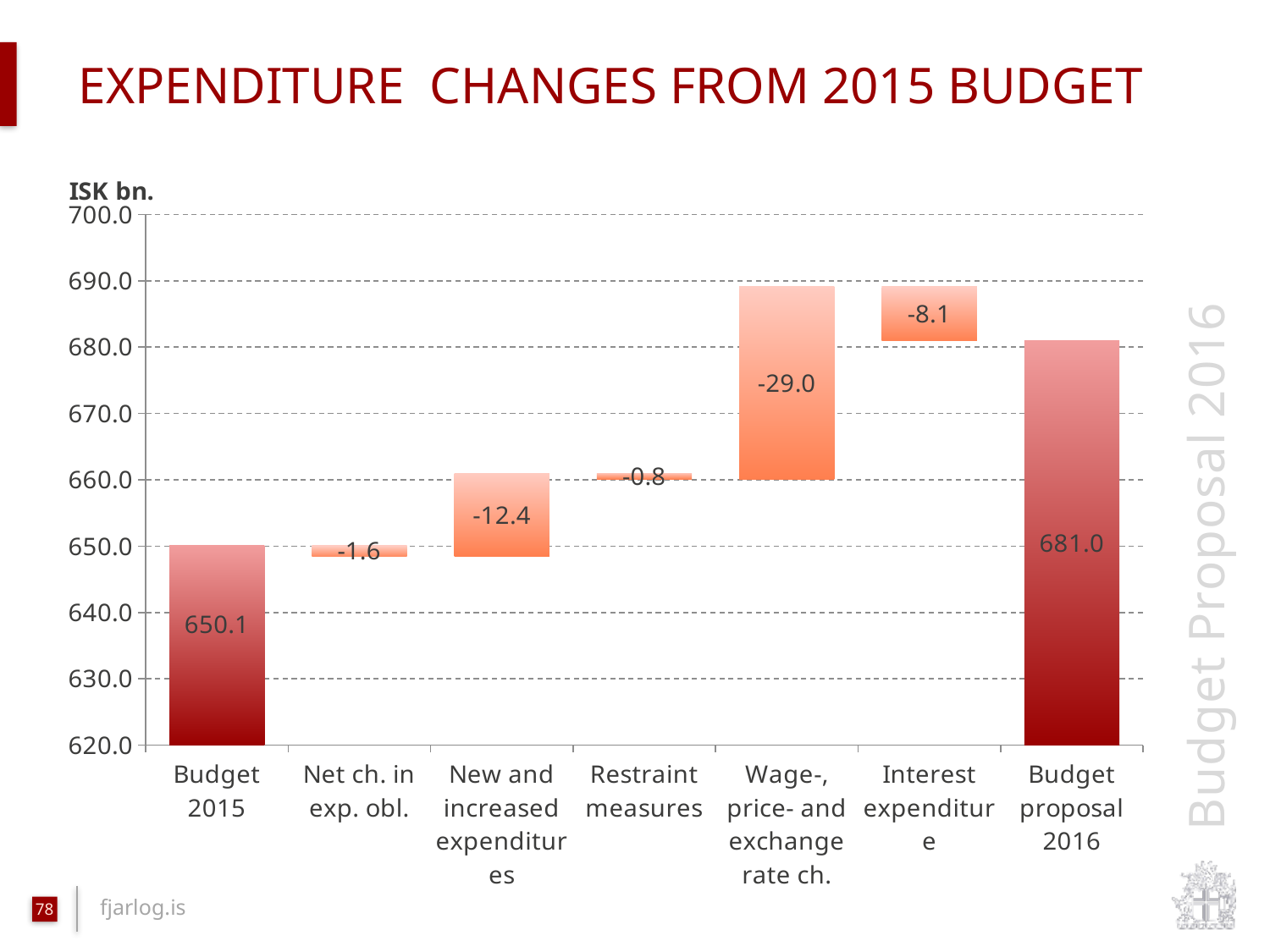
What value is labelled on the Net ch. in exp. obl. bar? -1.6 Which is larger, the value for Budget 2015 or the value for Budget proposal 2016? Budget proposal 2016 What is the value shown for Budget 2015? 650.1 What unit is indicated above the vertical axis? ISK bn. How many categories are shown on the x axis? 7 What kind of chart is shown on the slide? Bar chart By how much does the Budget proposal 2016 value exceed the Budget 2015 value? 30.9 What value is labelled on the New and increased expenditures bar? -12.4 What value is labelled on the Restraint measures bar? -0.8 What value is labelled on the Wage-, price- and exchange rate ch. bar? -29.0 What value is labelled on the Interest expenditure bar? -8.1 What is the value shown for Budget proposal 2016? 681.0